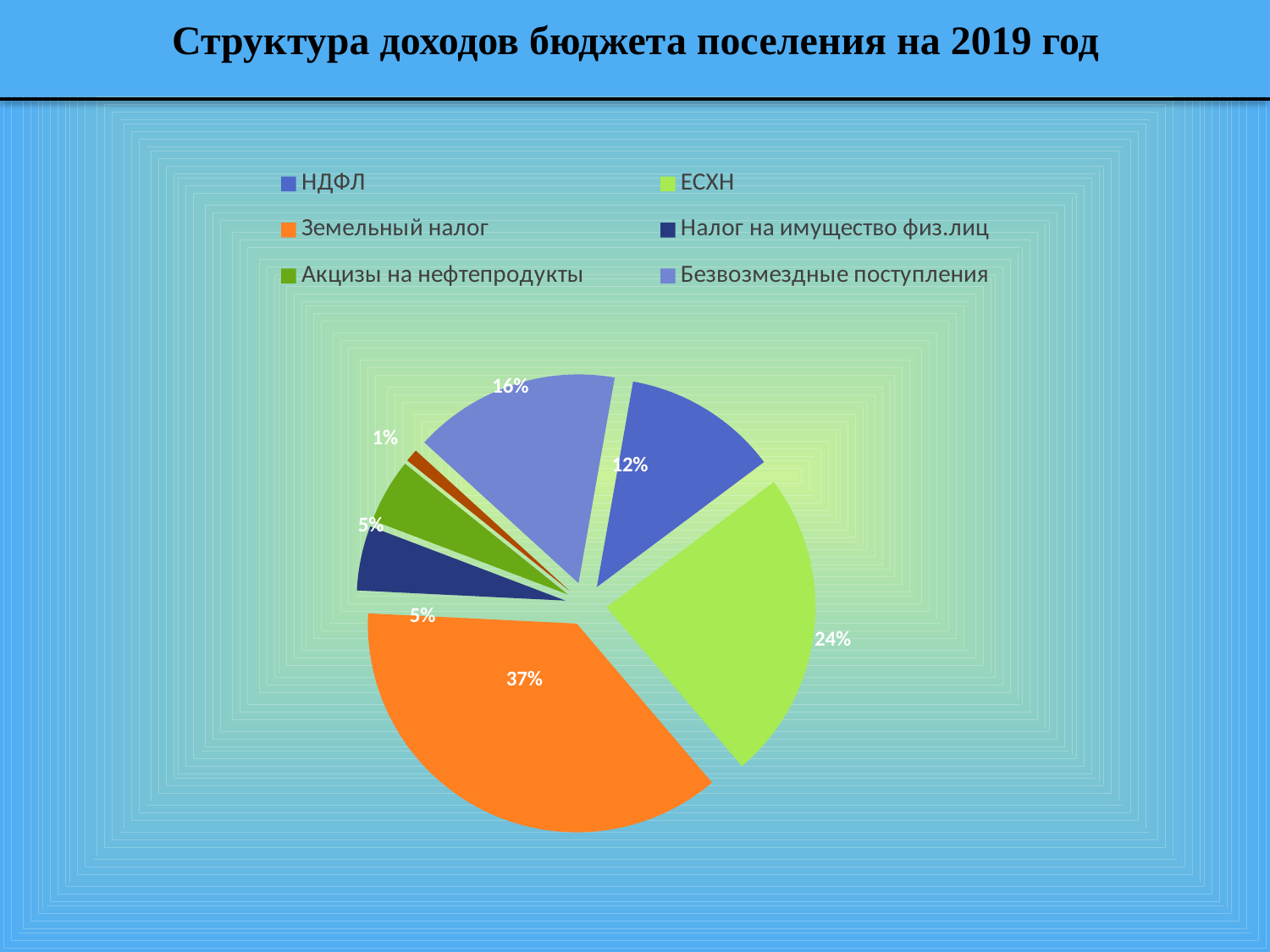
Which category has the largest slice of the pie? Земельный налог What percentage is shown for ЕСХН? 24% How many entries does the legend list? 6 What percentage does Налог на имущество физ.лиц account for? 5% What is the value of the НДФЛ slice? 12% By how many percentage points does Земельный налог exceed ЕСХН? 13 What share of the pie does Земельный налог have? 37% What is the share of Акцизы на нефтепродукты? 5% What type of chart is shown on the slide? Pie chart What is the title of the slide? Структура доходов бюджета поселения на 2019 год Which is larger, the share of ЕСХН or the share of НДФЛ? ЕСХН What share is labelled for Безвозмездные поступления? 16%